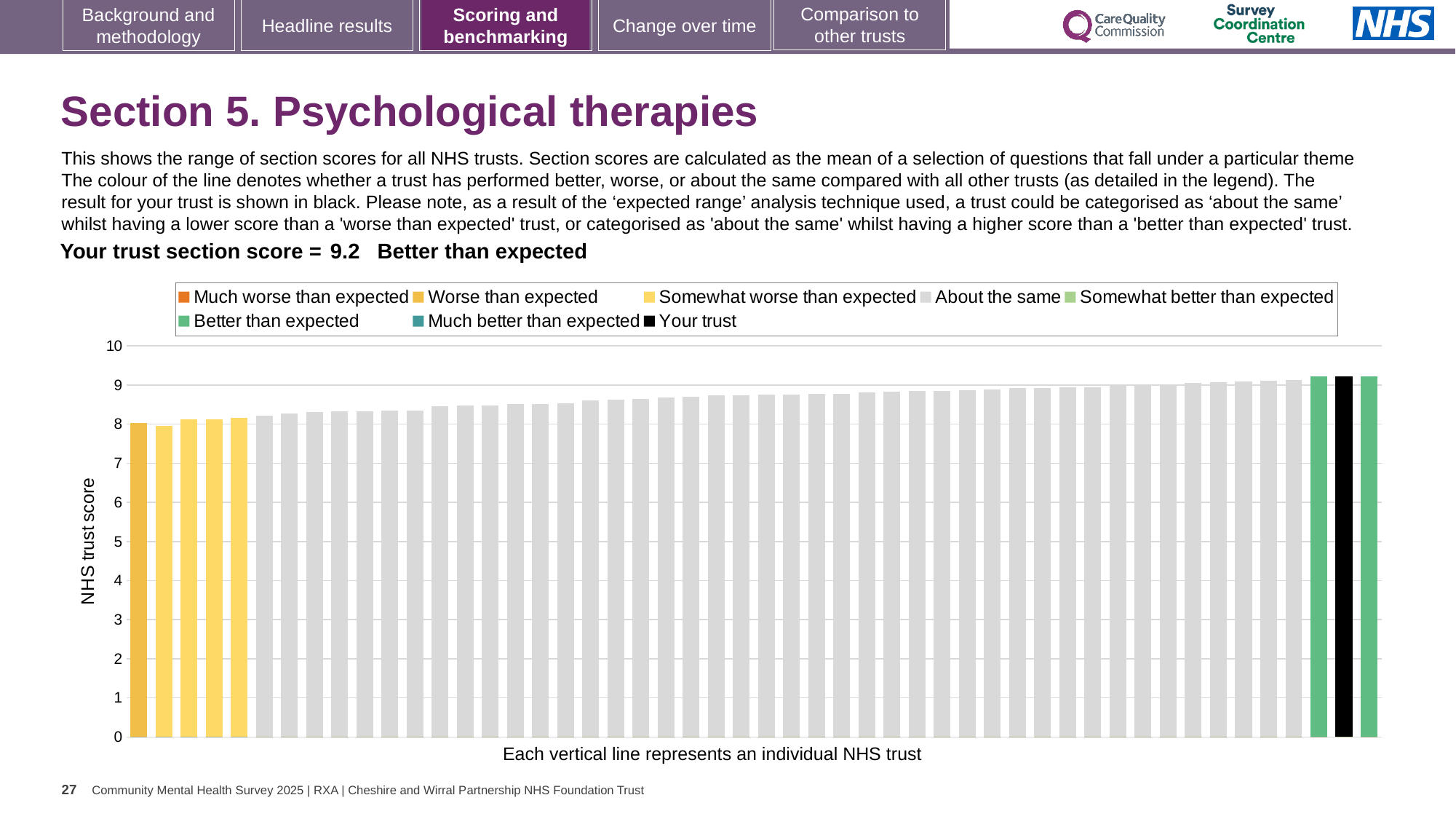
Which legend category do most of the bars in the chart belong to? About the same Is the value for your trust's bar greater or less than 9? greater What is the label on the vertical axis of the chart? NHS trust score How many entries does the chart legend list? 8 What is your trust's section score for Section 5, Psychological therapies? 9.2 What kind of chart is shown on the slide? bar chart What colour is the bar representing your trust? black Is the value for the leftmost bar greater or less than 9? less Do the bar values rise or fall from left to right across the chart? rise Is the value for the leftmost bar greater or less than 7? greater What is the maximum value shown on the vertical axis? 10 How is your trust's section score categorised compared with other trusts? Better than expected